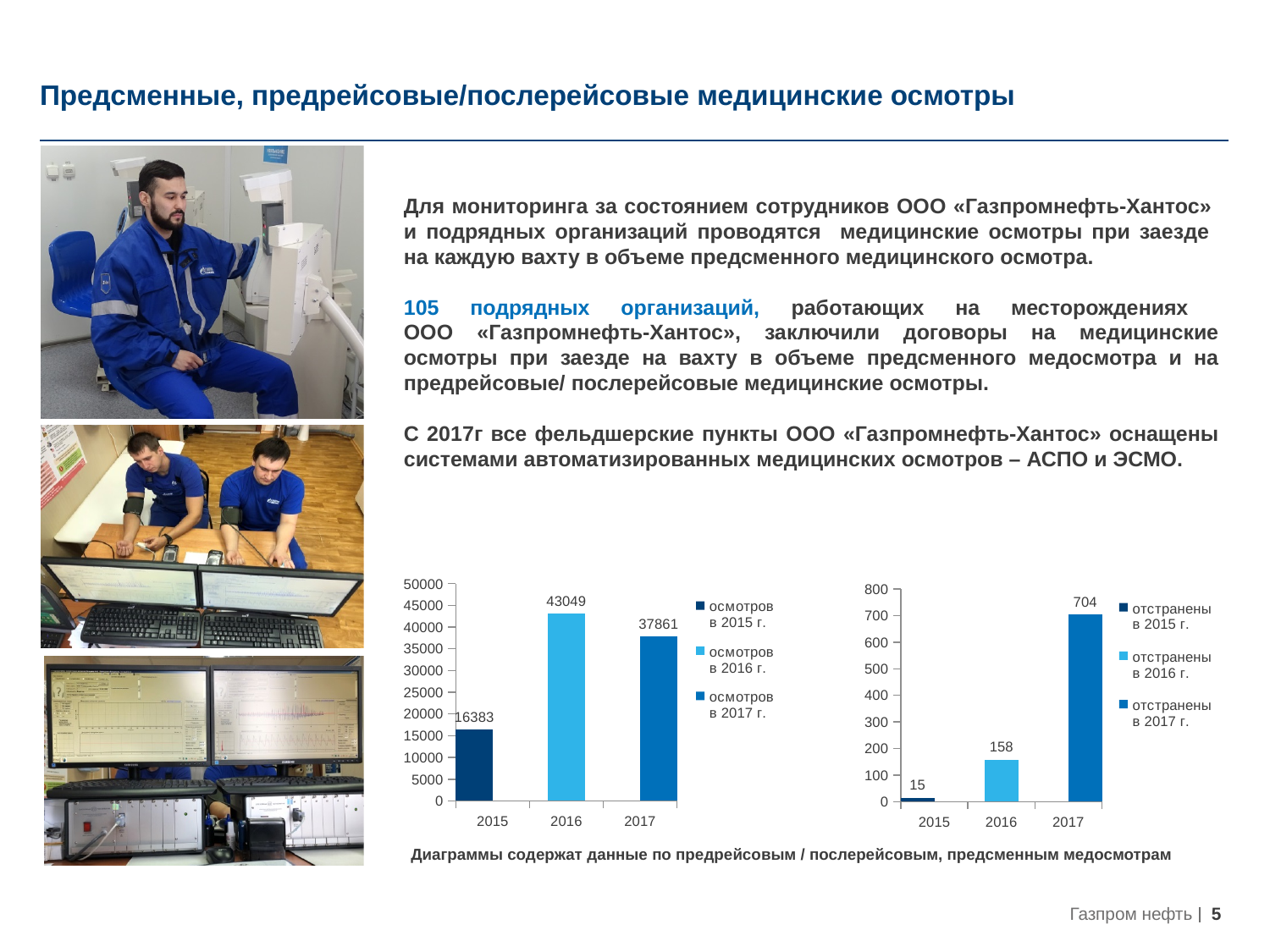
How many entries does the legend of the left chart list? 3 In the left chart, what is the value for 2015? 16383 In the right chart, what is the value for 2017? 704 In the right chart, which year has the lowest value? 2015 In the left chart, which year has the highest value? 2016 In the left chart, what is the value for 2016? 43049 In the left chart, which is larger: the value for 2015 or the value for 2017? 2017 How many bars are plotted in the right chart? 3 In the right chart, what is the difference between the values for 2017 and 2016? 546 In the right chart, what is the value for 2016? 158 In the left chart, what is the difference between the values for 2016 and 2017? 5188 What kind of chart is the right chart? bar chart